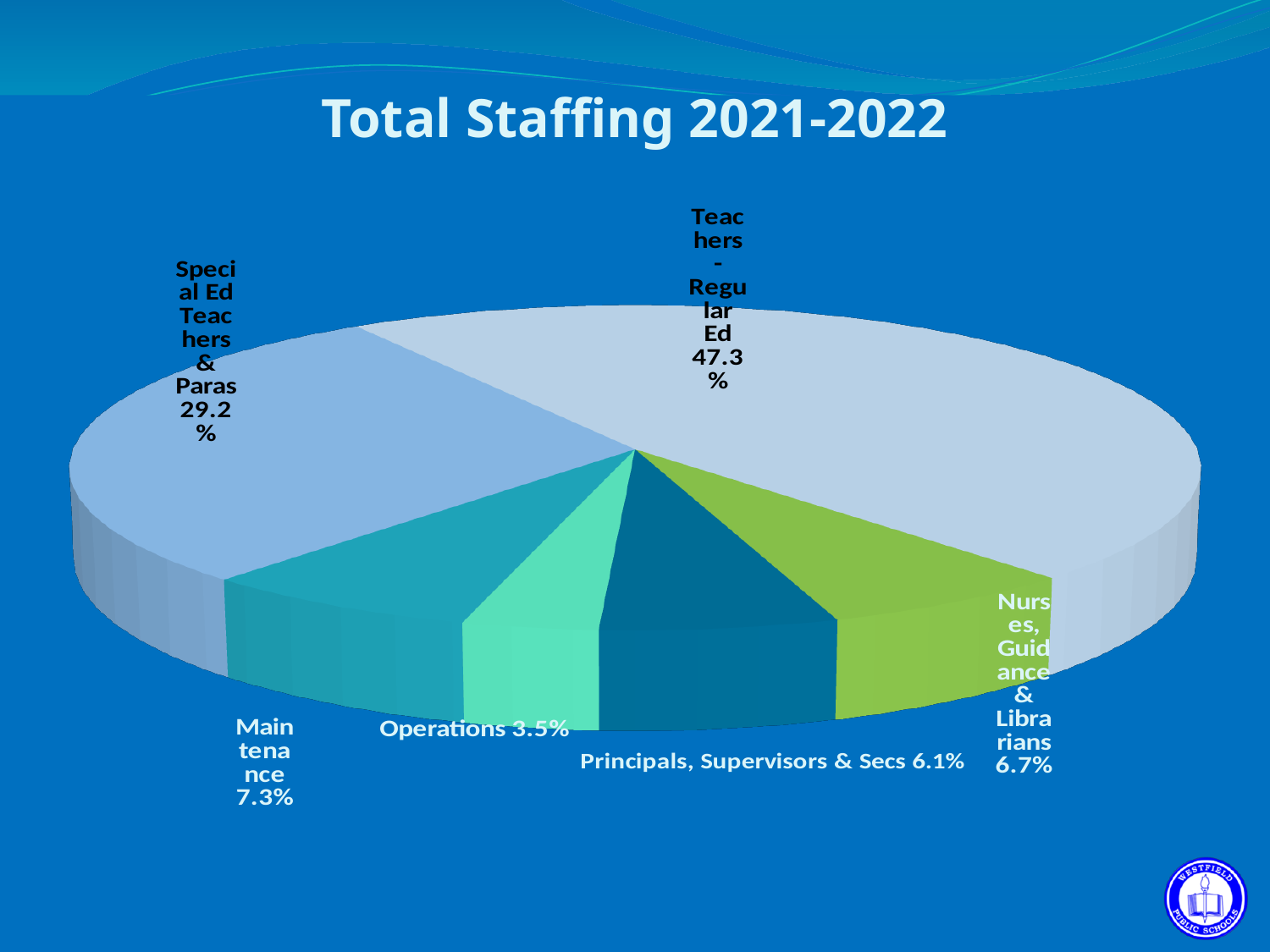
What share of total staffing is Teachers - Regular Ed? 47.3% What share of total staffing is Nurses, Guidance & Librarians? 6.7% What share of total staffing is Operations? 3.5% How many categories are shown in the pie chart? 6 What is the title of the chart? Total Staffing 2021-2022 Which category has the smallest share of the pie? Operations What share of total staffing is Special Ed Teachers & Paras? 29.2% Which category has the largest share of the pie? Teachers - Regular Ed What share of total staffing is Maintenance? 7.3% What share of total staffing is Principals, Supervisors & Secs? 6.1% What kind of chart is shown on the slide? Pie chart What is the difference in percentage points between Teachers - Regular Ed and Special Ed Teachers & Paras? 18.1